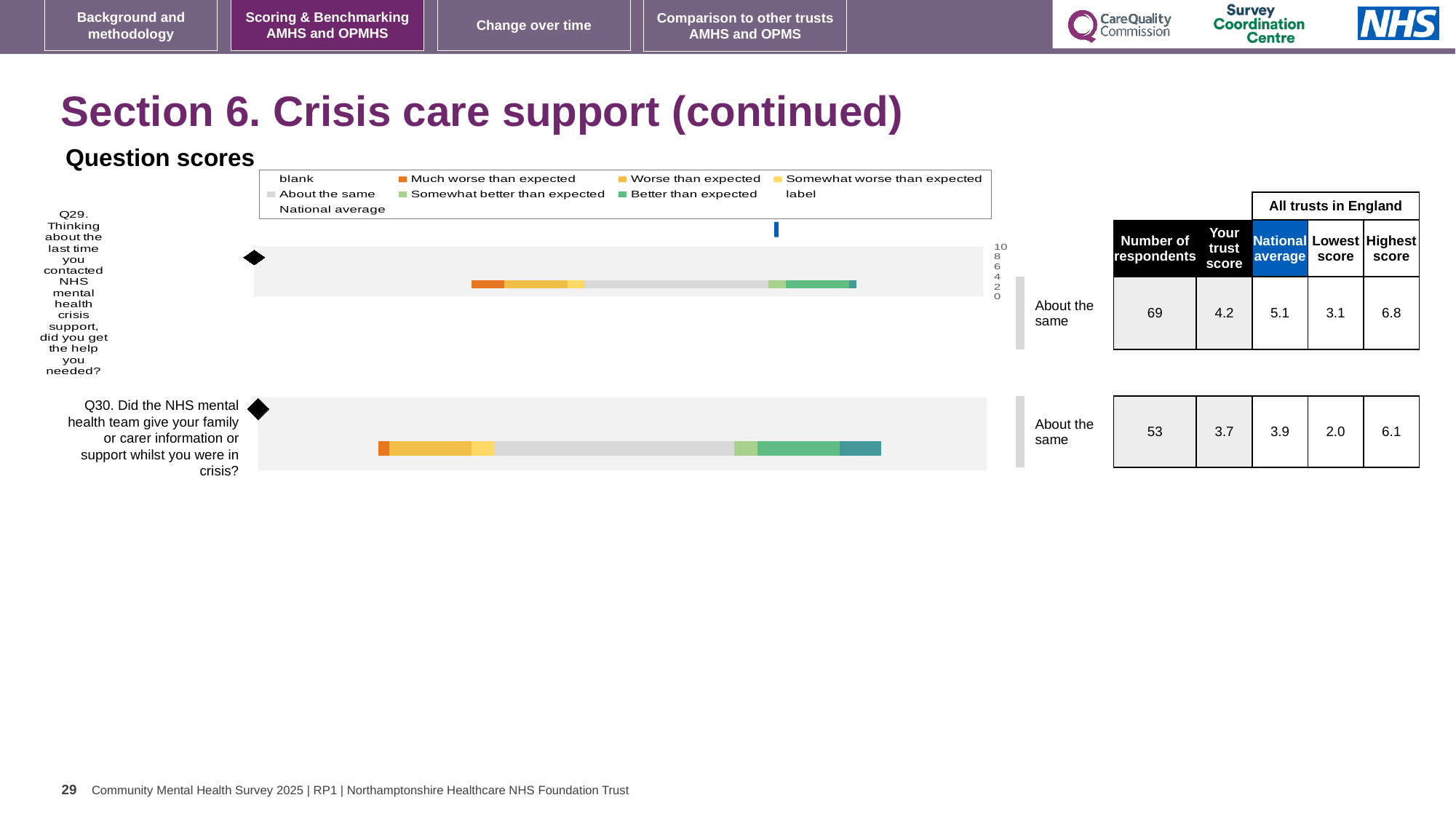
What kind of chart is used to show the question scores for Q29 and Q30? bar chart Which legend entry is shown in orange? Much worse than expected Which question's bar has the larger 'Better than expected' (dark teal) segment, Q29 or Q30? Q30 How many questions are plotted as bars on the slide? 2 What rating label is shown next to the bar for Q30? About the same What rating label is shown next to the bar for Q29? About the same What is the highest tick value shown on the chart axis? 10